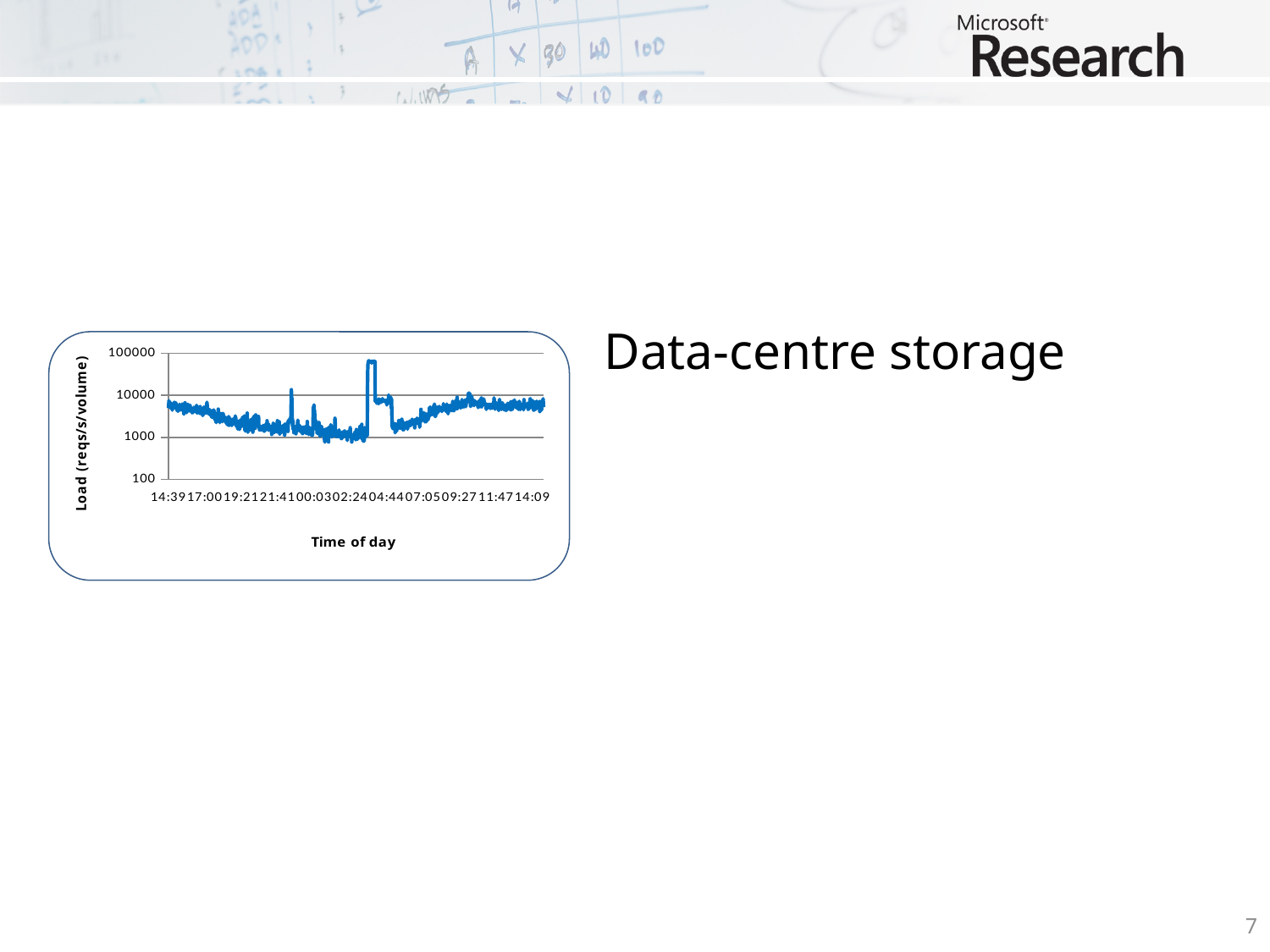
What is the highest value shown on the y-axis? 100000 Is the load value at 14:39 greater or less than 1000? greater What is the lowest value shown on the y-axis? 100 How many time-of-day tick labels are shown on the x-axis? 11 What is the label of the x-axis of the chart? Time of day What kind of chart is shown on the slide? line chart Is the peak load value of the spike near 04:44 greater or less than 10000? greater Is the load value at 00:03 greater or less than 10000? less What is the first time-of-day label on the x-axis? 14:39 What is the last time-of-day label on the x-axis? 14:09 What is the label of the y-axis of the chart? Load (reqs/s/volume)